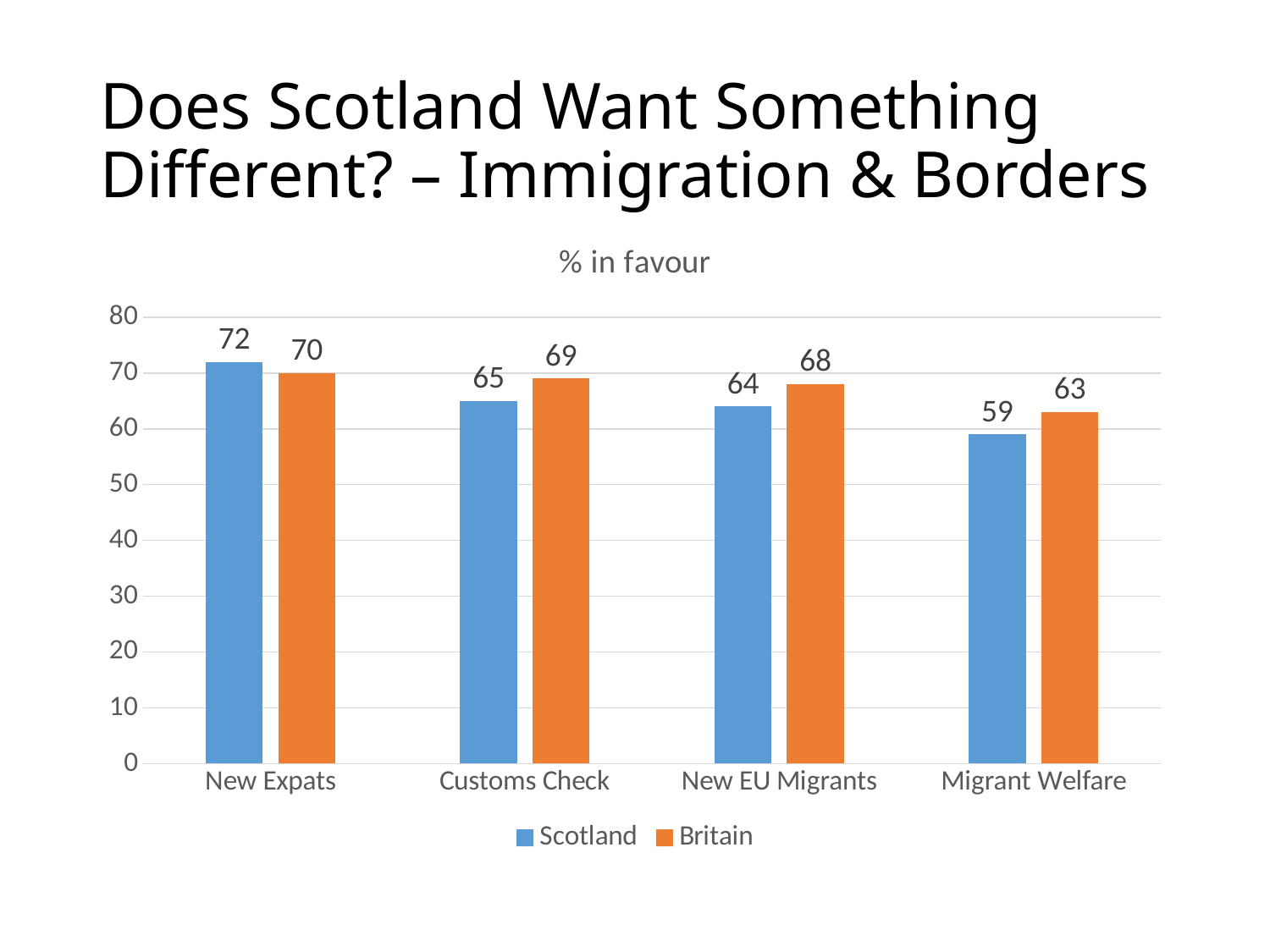
What is the Britain value for Customs Check? 69 What is the title of the chart? % in favour How many categories are shown on the x axis? 4 What is the Britain value for Migrant Welfare? 63 Is the Scotland value for Migrant Welfare greater or less than 60? less What is the difference between the Britain and Scotland values for New EU Migrants? 4 Which category has the lowest Britain value? Migrant Welfare What kind of chart is shown on the slide? bar chart Which category has the highest Scotland value? New Expats What is the Scotland value for New Expats? 72 How many series does the legend list? 2 Which is larger for Customs Check, the Scotland value or the Britain value? Britain